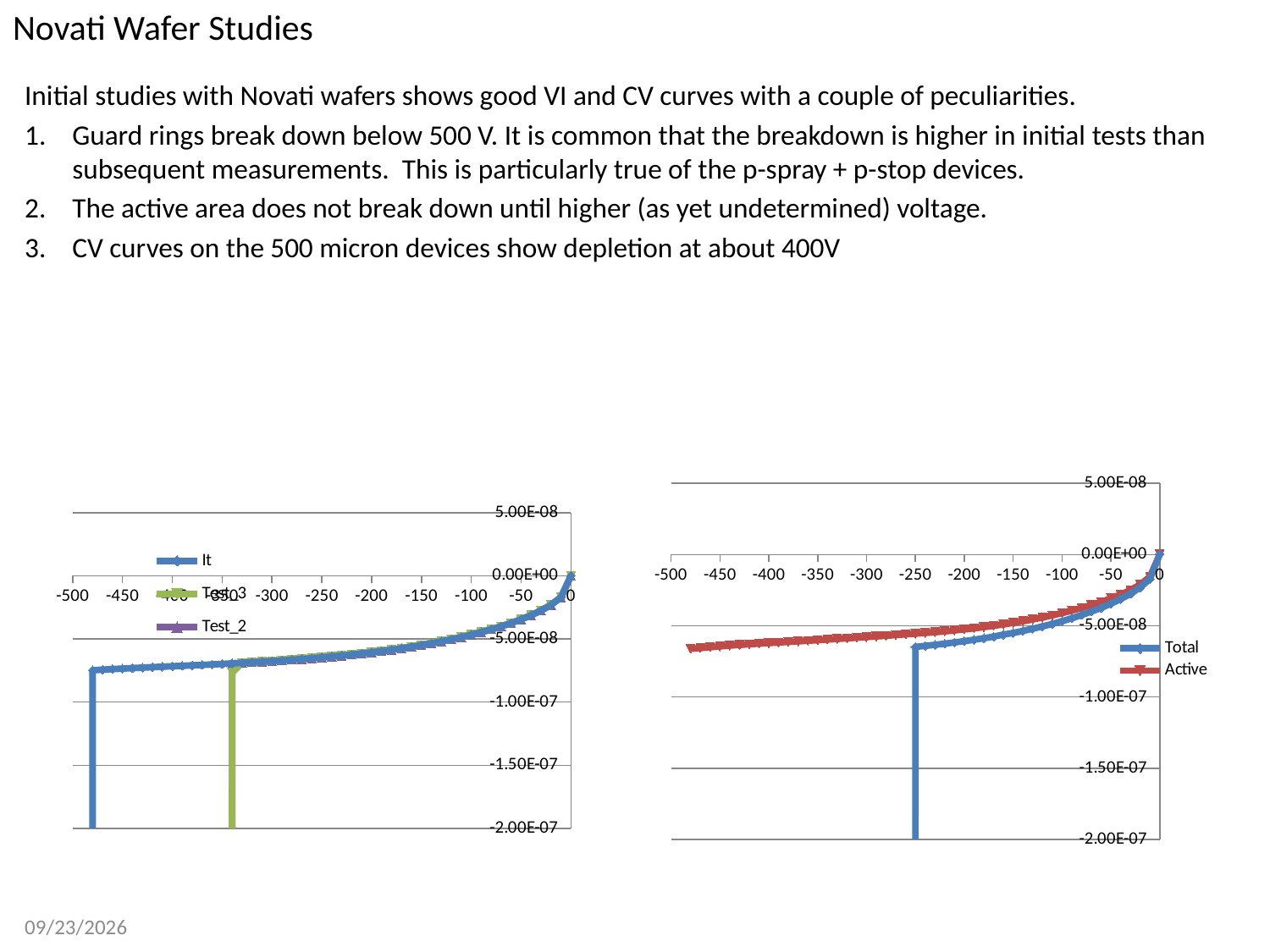
In the right chart, is the value of the Active series at -450 greater or less than -5.00E-08? less In the right chart, which series drops vertically (breaks down) within the plotted voltage range, Total or Active? Total In the left chart, which series drops vertically (breaks down) at a more negative voltage, It or Test_3? It In the right chart, do the values of the Active series rise or fall as the voltage goes from -500 toward 0 along the x axis? rise In the left chart, is the value of the It series at -200 greater or less than -1.00E-07? greater What kind of chart is the chart on the left of the slide? line chart What kind of chart is the chart on the right of the slide? line chart In the left chart, what are the names of the series in the legend? It, Test_3, Test_2 How many series does the legend of the right chart list? 2 In the right chart, which series is drawn in red? Active In the right chart, is the value of the Total series at -100 greater or less than -5.00E-08? greater How many series does the legend of the left chart list? 3